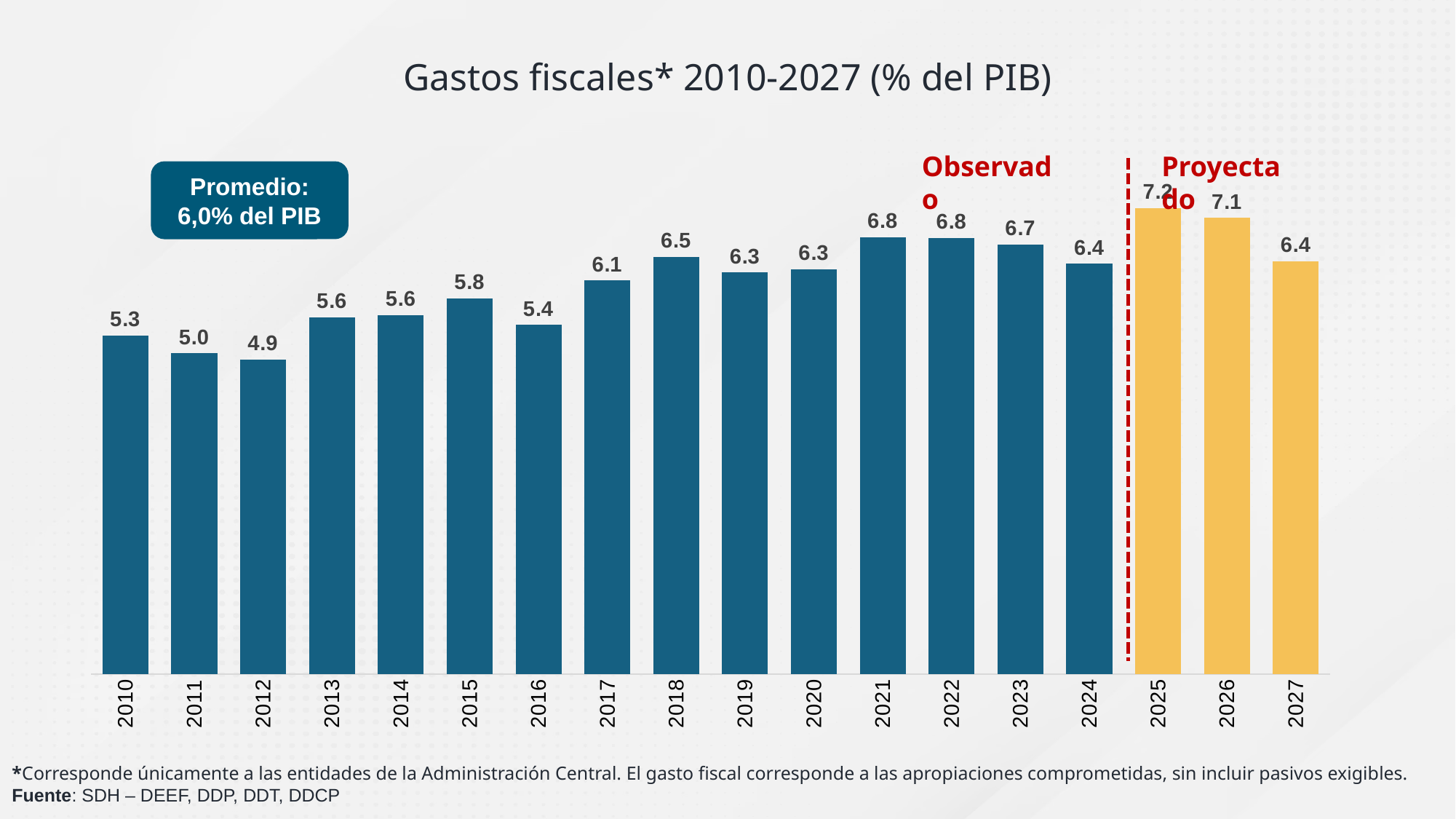
What is the projected value for 2027? 6.4 Which year has the highest value? 2025 What kind of chart is this? Bar chart What is the value for 2012? 4.9 Do the values generally rise or fall from 2012 to 2021? Rise What is the title of the chart? Gastos fiscales* 2010-2027 (% del PIB) How many years are shown on the x axis? 18 Which is larger, the value for 2015 or the value for 2016? 2015 What average value is stated in the box on the chart? 6,0% del PIB What is the difference between the values for 2025 and 2010? 1.9 Which year has the lowest value? 2012 What is the value for 2018? 6.5